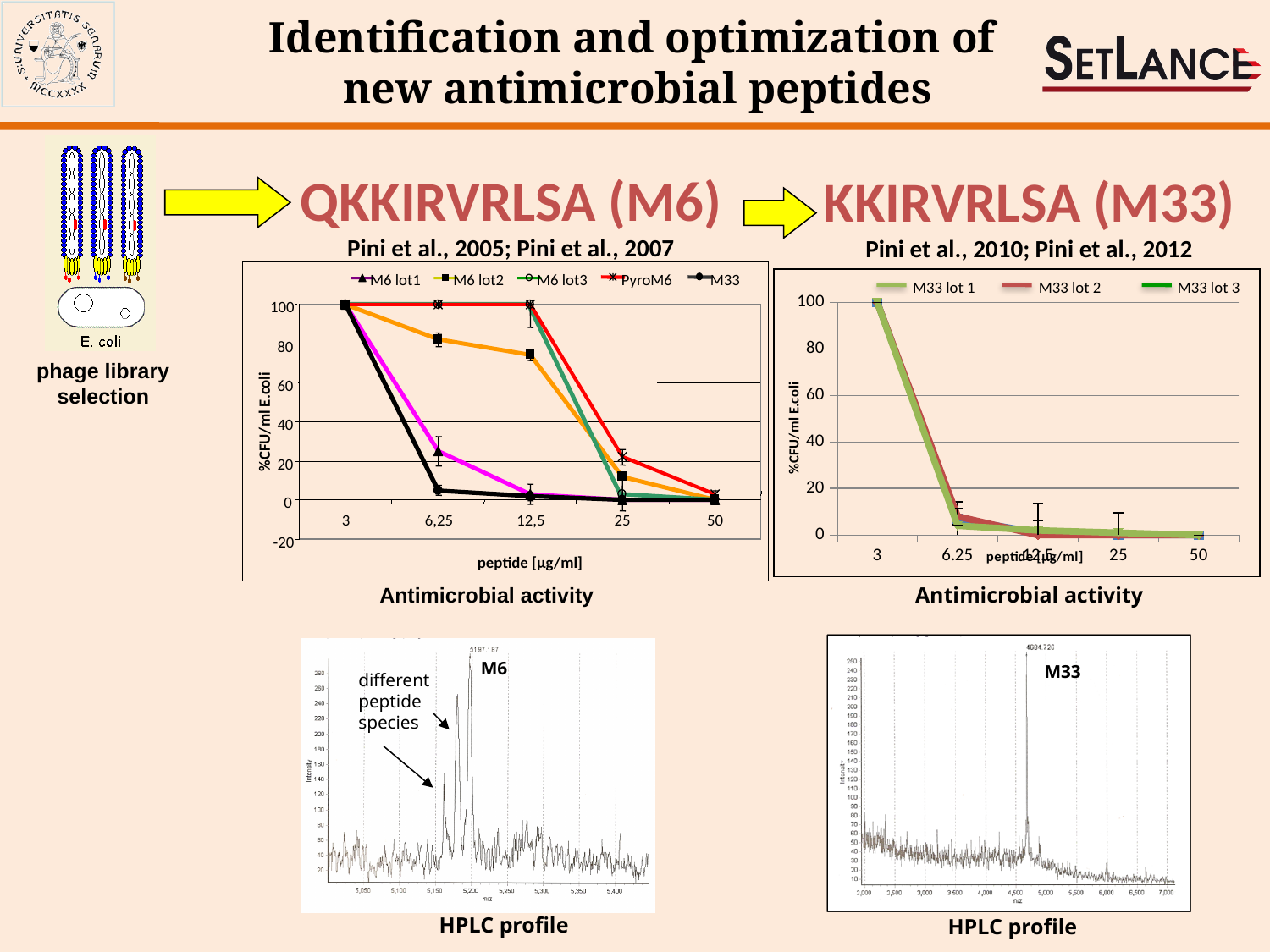
In the left 'Antimicrobial activity' chart (M6), which is larger at 12,5 µg/ml: PyroM6 or M6 lot2? PyroM6 How many series does the legend of the right 'Antimicrobial activity' chart (M33) list? 3 In the left 'Antimicrobial activity' chart (M6), is the value for M33 at 6,25 µg/ml greater or less than 20? less What is the y-axis label of the left 'Antimicrobial activity' chart (M6)? %CFU/ml E.coli In the left 'Antimicrobial activity' chart (M6), which is larger at 6,25 µg/ml: M6 lot2 or M33? M6 lot2 What kind of chart is the 'Antimicrobial activity' chart on the left (under QKKIRVRLSA (M6))? line chart In the right 'Antimicrobial activity' chart (M33), is the value for M33 lot 1 at 6.25 µg/ml greater or less than 20? less In the left 'Antimicrobial activity' chart (M6), is the value for PyroM6 at 25 µg/ml greater or less than 40? less How many peptide concentrations are shown on the x axis of the right 'Antimicrobial activity' chart (M33)? 5 How many series does the legend of the left 'Antimicrobial activity' chart (M6) list? 5 In the right 'Antimicrobial activity' chart (M33), do the values rise or fall as the peptide concentration increases along the x axis? fall